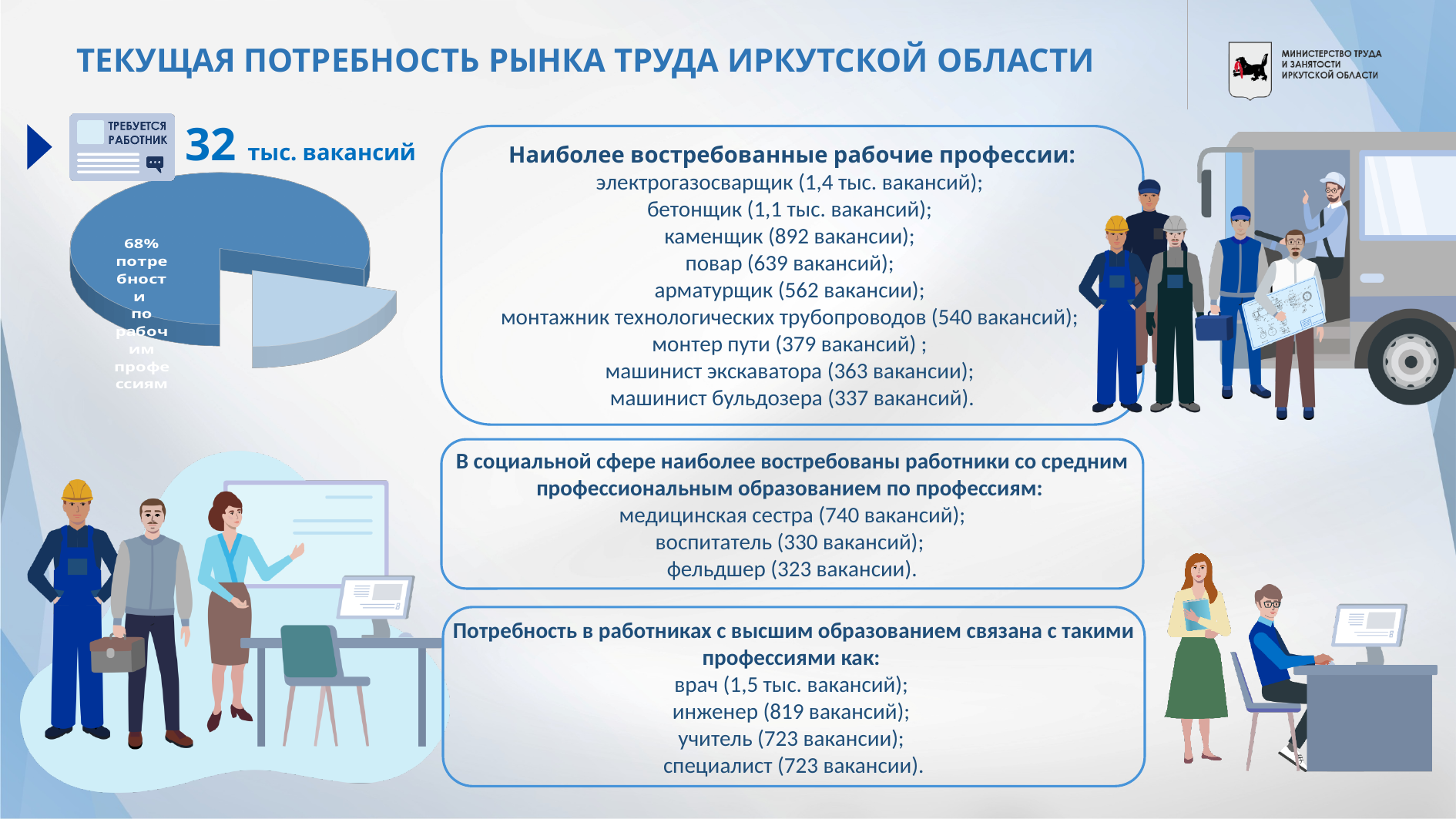
What kind of chart is shown on the left of the slide, below the "32 тыс. вакансий" figure? pie chart Does the pie chart on the left of the slide have a legend? No In the pie chart on the left of the slide, which slice is larger: the slice labelled 68% or the unlabelled slice? the slice labelled 68% In the pie chart on the left of the slide, is the slice labelled "потребности по рабочим профессиям" more or less than half of the pie? more How many slices does the pie chart on the left of the slide have? 2 What text is printed on the large slice of the pie chart on the left of the slide? 68% потребности по рабочим профессиям In the pie chart on the left of the slide, what share is shown for the slice labelled "потребности по рабочим профессиям"? 68%